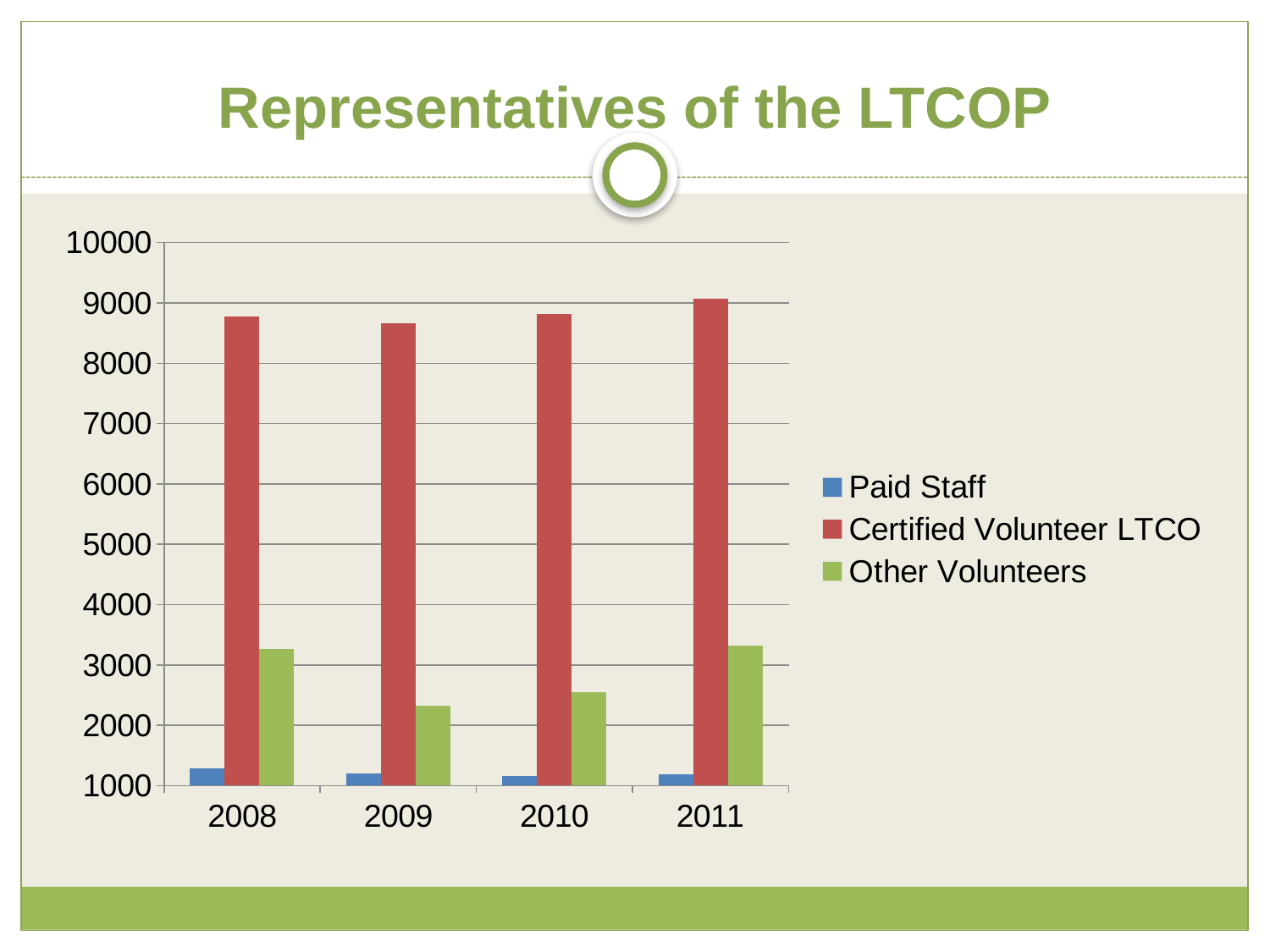
What kind of chart is shown on the slide? bar chart Which is larger, the Other Volunteers value in 2010 or in 2009? 2010 In which year is the Other Volunteers bar the lowest? 2009 Is the value for Certified Volunteer LTCO in 2011 greater or less than 9000? greater Is the value for Other Volunteers in 2009 greater or less than 2000? greater What is the title of the slide containing the chart? Representatives of the LTCOP How many years are shown on the x axis of the chart? 4 Is the value for Certified Volunteer LTCO in 2009 greater or less than 9000? less In 2008, which series has the larger value, Certified Volunteer LTCO or Other Volunteers? Certified Volunteer LTCO How many series does the chart's legend list? 3 In which year is the Certified Volunteer LTCO bar the highest? 2011